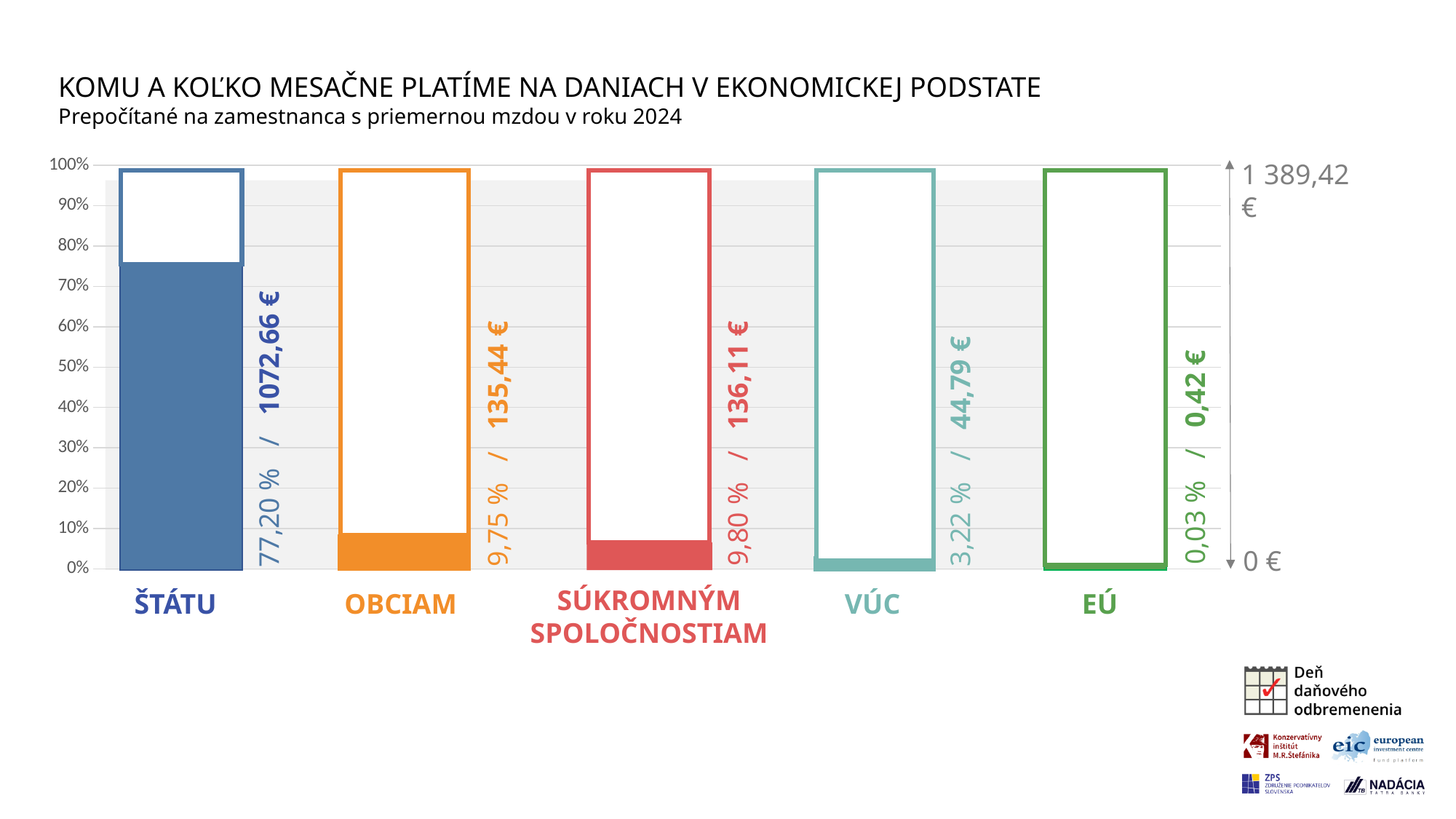
What total amount in euros is shown at the top of the right-hand scale? 1 389,42 € What kind of chart is this? bar chart What monthly amount in euros is shown for SÚKROMNÝM SPOLOČNOSTIAM? 136,11 € What is the difference in euros between the amounts for SÚKROMNÝM SPOLOČNOSTIAM and OBCIAM? 0,67 € Which category has the lowest share? EÚ Which category has the highest share? ŠTÁTU What monthly amount in euros is shown for ŠTÁTU? 1072,66 € What monthly amount in euros is shown for VÚC? 44,79 € How many categories are shown on the x axis? 5 Which is larger, the amount for OBCIAM or for SÚKROMNÝM SPOLOČNOSTIAM? SÚKROMNÝM SPOLOČNOSTIAM What percentage share is shown for EÚ? 0,03 % What percentage share is shown for OBCIAM? 9,75 %